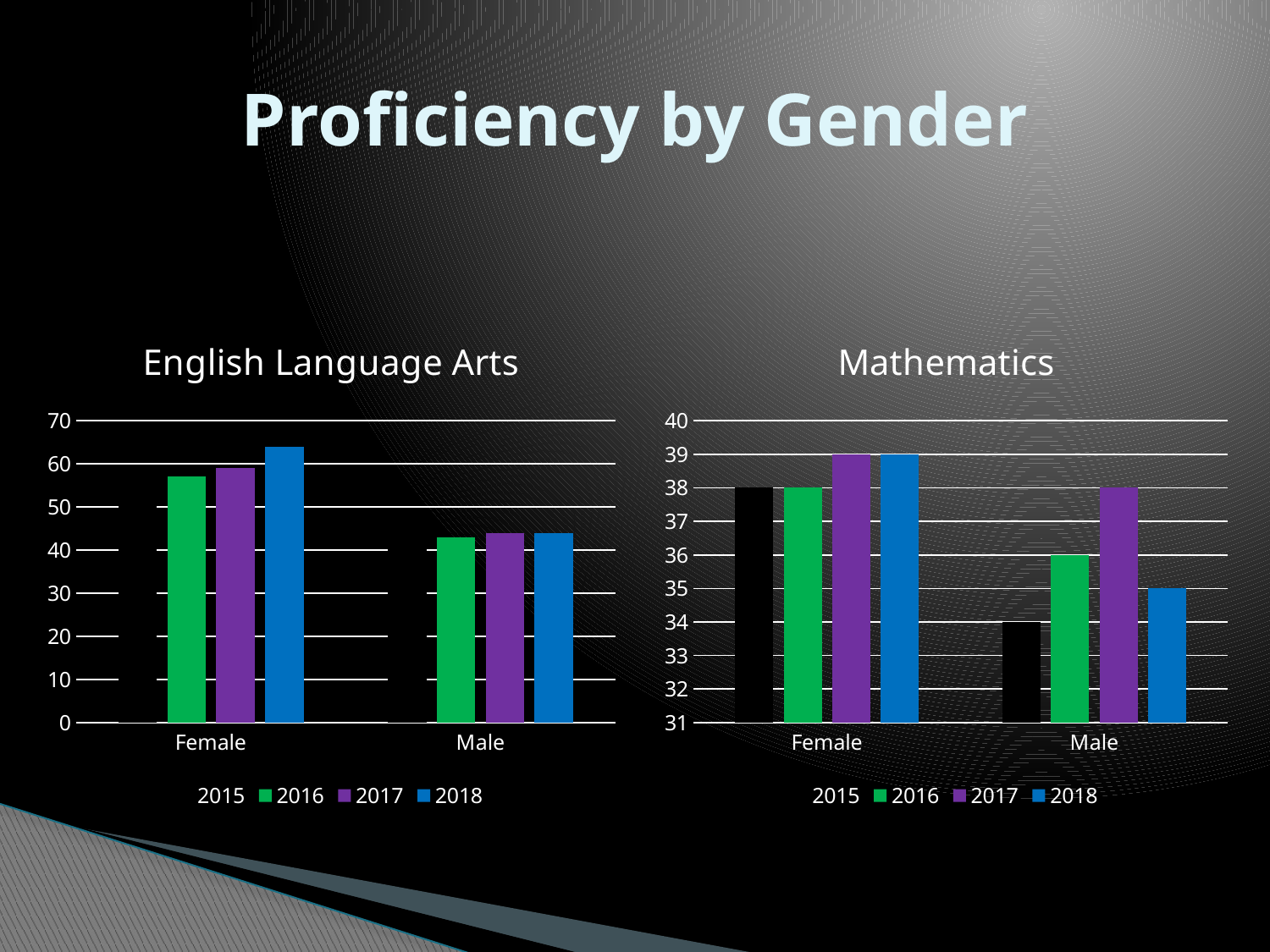
In the English Language Arts chart, which is larger, the 2018 value for Female or the 2018 value for Male? Female In the English Language Arts chart, is the 2016 value for Male greater or less than 50? less How many series does the legend of the Mathematics chart list? 4 In the Mathematics chart, which year has the lowest value for Male? 2015 In the Mathematics chart, what is the difference between the 2016 value for Female and the 2016 value for Male? 2 What is the title of the chart on the right side of the slide? Mathematics How many categories are shown on the x axis of the English Language Arts chart? 2 In the Mathematics chart, what is the 2015 value for Male? 34 In the Mathematics chart, which year has the highest value for Male? 2017 In the Mathematics chart, what is the 2017 value for Female? 39 In the English Language Arts chart, is the 2018 value for Female greater or less than 60? greater What kind of chart is the English Language Arts chart? bar chart